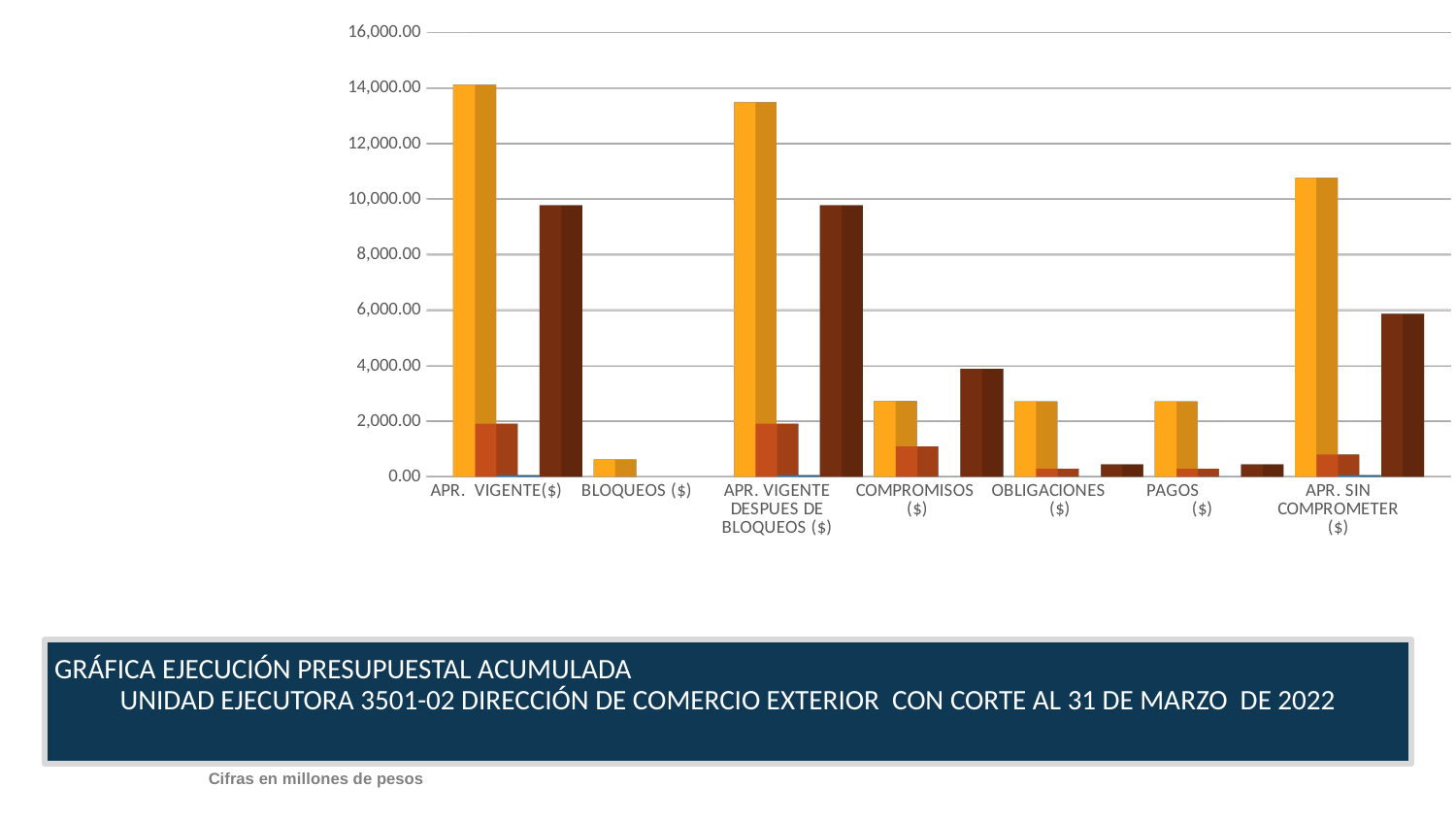
Which category has the tallest yellow bar? APR. VIGENTE($) Is the yellow bar for BLOQUEOS ($) greater or less than 2,000.00? less Is the yellow bar for APR. VIGENTE($) greater or less than 12,000.00? greater Is the dark brown bar for OBLIGACIONES ($) greater or less than 2,000.00? less Which is taller: the yellow bar for APR. VIGENTE($) or the yellow bar for APR. VIGENTE DESPUES DE BLOQUEOS ($)? APR. VIGENTE($) According to the note below the chart, in what units are the figures expressed? Cifras en millones de pesos Which category has the shortest yellow bar? BLOQUEOS ($) Which is taller: the dark brown bar for OBLIGACIONES ($) or the dark brown bar for COMPROMISOS ($)? COMPROMISOS ($) How many categories are shown along the x axis of the chart? 7 What kind of chart is shown on the slide? bar chart